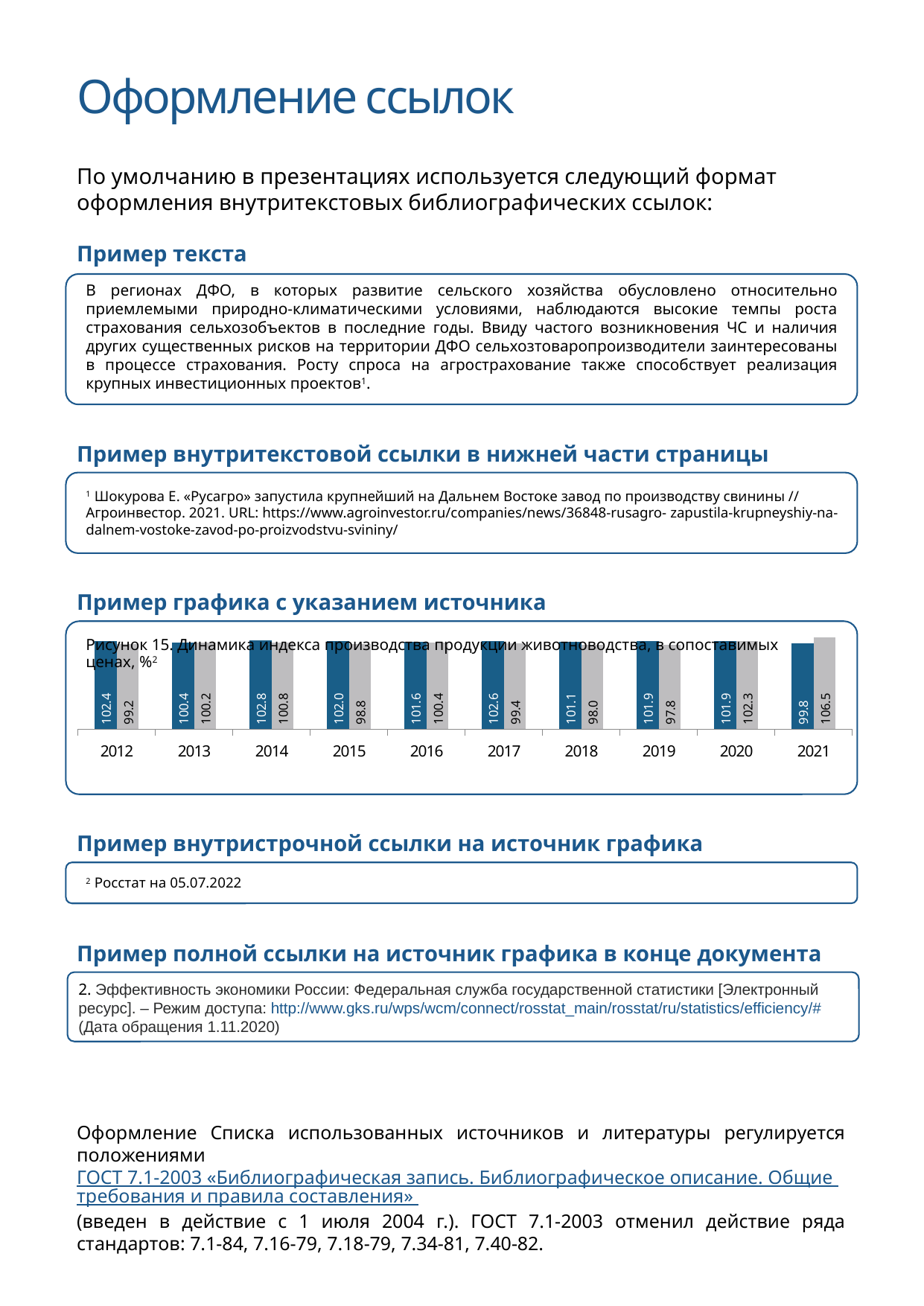
How many years are shown on the x axis of the chart? 10 In which year is the grey bar highest? 2021 What is the value of the blue bar for 2012? 102.4 What is the value of the grey bar for 2018? 98.0 What is the difference between the grey bar and the blue bar for 2021? 6.7 In which year is the blue bar highest? 2014 For 2018, which is larger: the blue bar or the grey bar? The blue bar What is the value of the grey bar for 2021? 106.5 In which year is the grey bar lowest? 2019 In which year is the blue bar lowest? 2021 What is the figure number given in the chart title? Рисунок 15 What kind of chart is shown on the slide? Bar chart